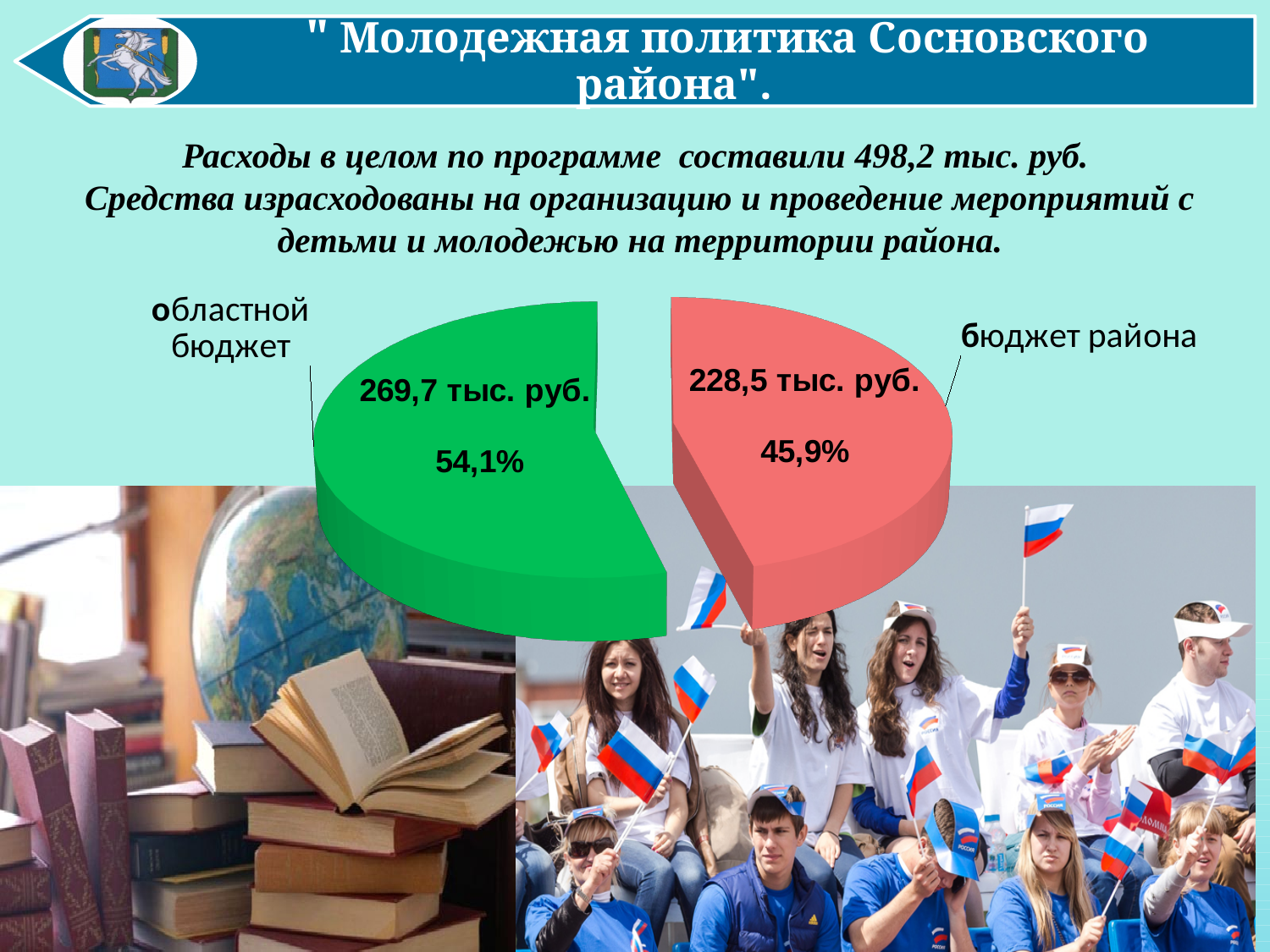
Which is larger, областной бюджет or бюджет района? областной бюджет What share of the pie does областной бюджет represent? 54,1% What kind of chart is shown on the slide? pie chart What amount is shown for областной бюджет? 269,7 тыс. руб. What colour is the slice for бюджет района? red What is the difference in тыс. руб. between областной бюджет and бюджет района? 41,2 тыс. руб. Which slice of the pie chart is the largest? областной бюджет What amount is shown for бюджет района? 228,5 тыс. руб. What is the total of the two slices in тыс. руб.? 498,2 тыс. руб. What share of the pie does бюджет района represent? 45,9% Which slice of the pie chart is the smallest? бюджет района How many slices does the pie chart have? 2